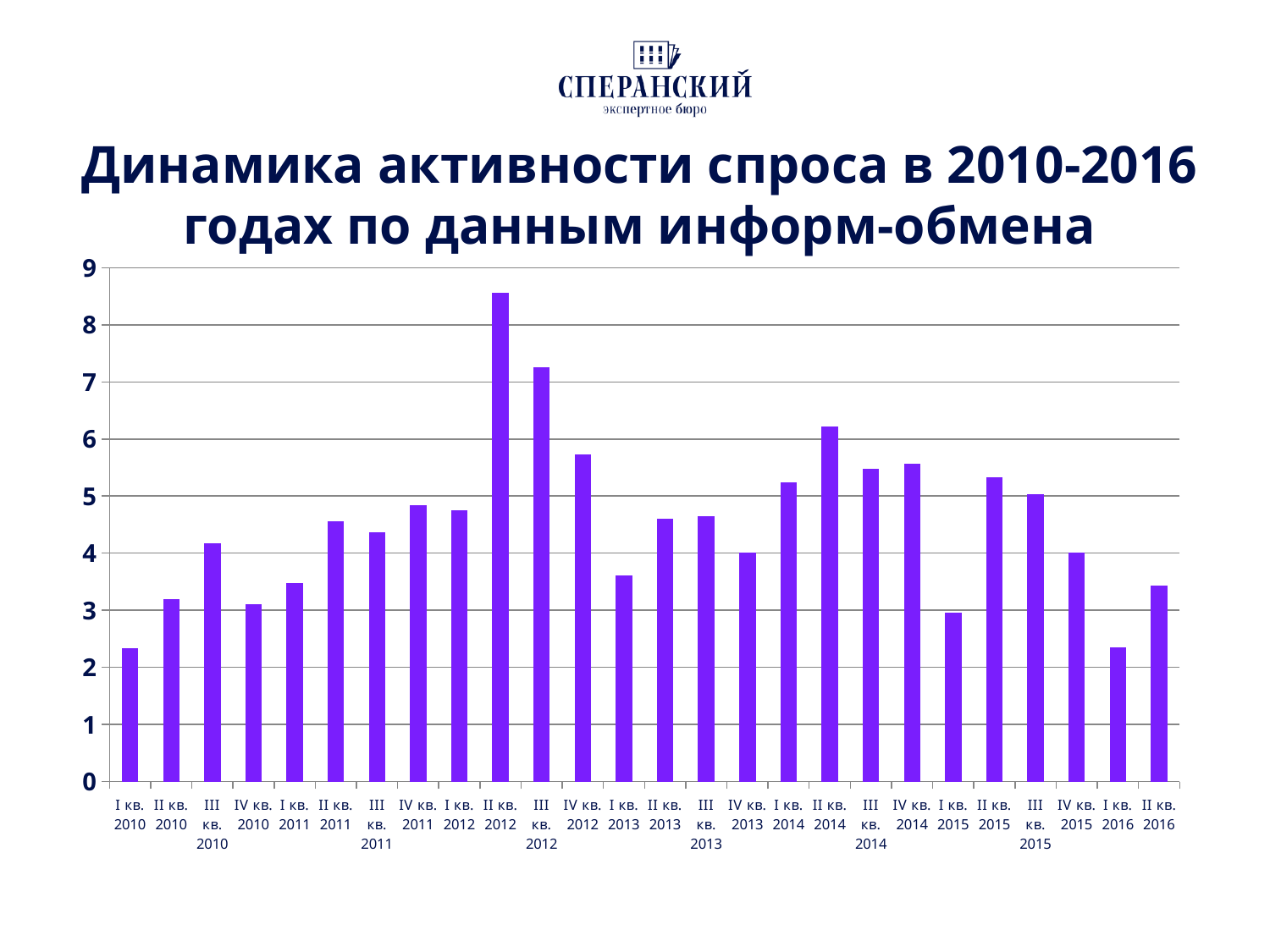
Which is larger, the value for III кв. 2015 or the value for IV кв. 2015? III кв. 2015 Is the value for III кв. 2012 greater or less than 7? greater Which is larger, the value for I кв. 2014 or the value for II кв. 2014? II кв. 2014 Is the value for II кв. 2014 greater or less than 6? greater Is the value for II кв. 2012 greater or less than 8? greater What is the title of the chart on the slide? Динамика активности спроса в 2010-2016 годах по данным информ-обмена Which quarter has the highest value in the chart? II кв. 2012 What kind of chart is shown on the slide? bar chart How many quarters (bars) are plotted in the chart? 26 Do the values rise or fall from II кв. 2012 to I кв. 2013? fall